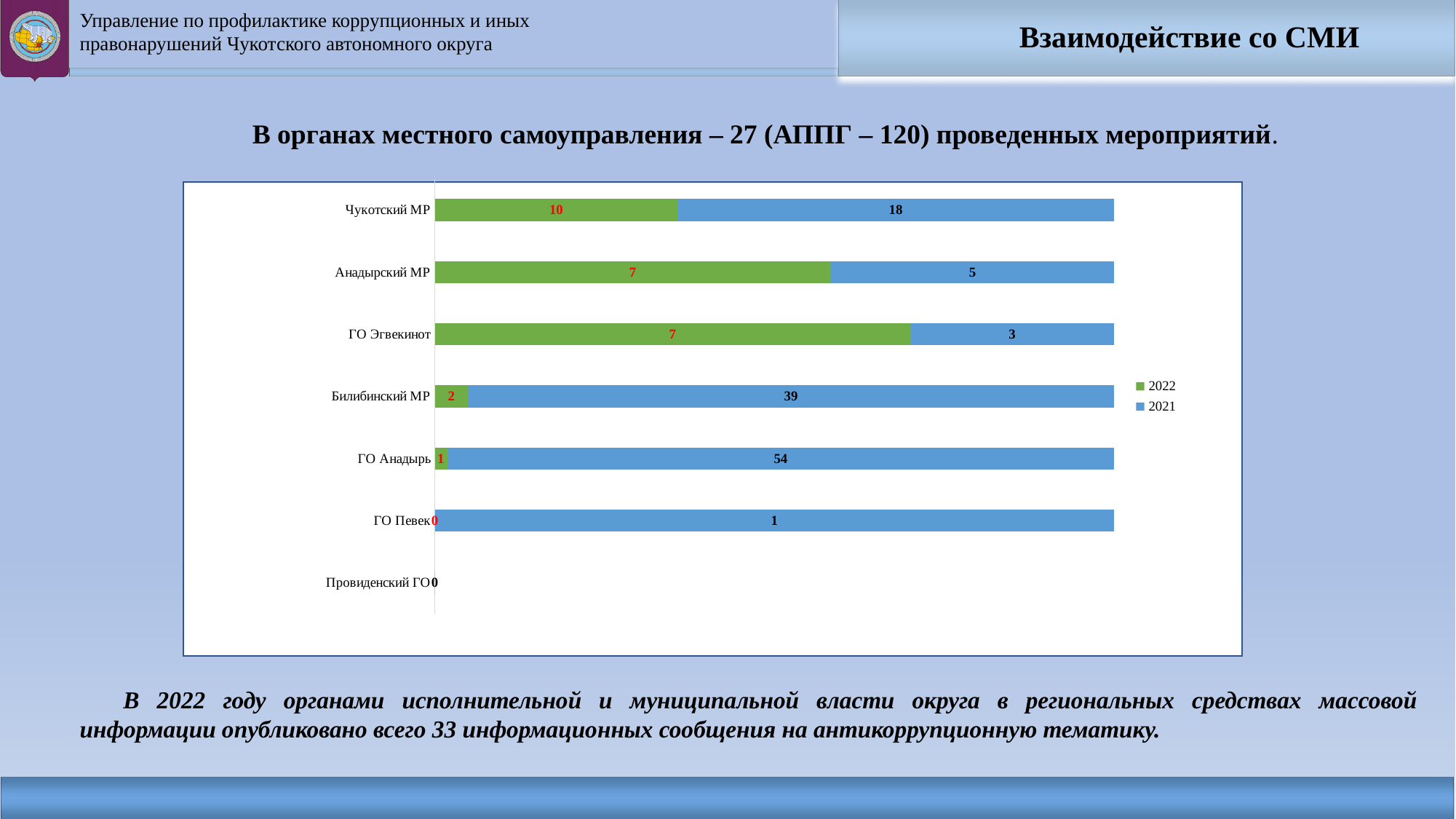
Which category has the highest 2022 value? Чукотский МР What is the total of the 2022 and 2021 values for Чукотский МР? 28 Which is larger for Анадырский МР, the 2022 value or the 2021 value? 2022 Which category has the highest 2021 value? ГО Анадырь What is the 2021 value for Билибинский МР? 39 What is the 2021 value for ГО Анадырь? 54 What is the 2022 value for Чукотский МР? 10 What type of chart is shown on the slide? bar chart What is the 2022 value for ГО Эгвекинот? 7 What is the difference between the 2021 and 2022 values for Билибинский МР? 37 How many series does the chart legend list? 2 How many categories are shown on the chart? 7